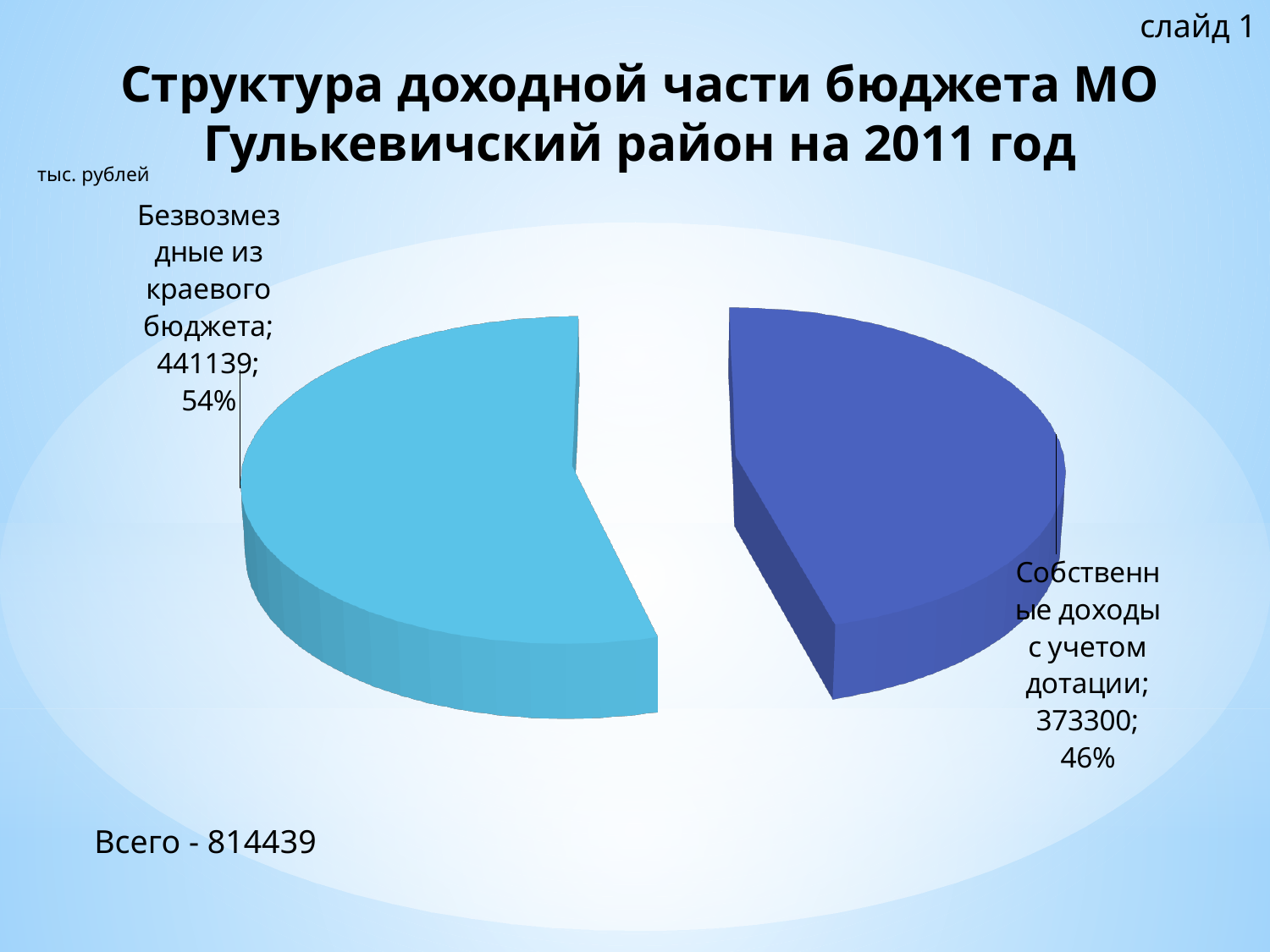
What kind of chart is shown on the slide? Pie chart Which is larger: 'Безвозмездные из краевого бюджета' or 'Собственные доходы с учетом дотации'? Безвозмездные из краевого бюджета Which category has the largest slice of the pie? Безвозмездные из краевого бюджета What is the total of all values shown in the chart? 814439 What is the value for 'Собственные доходы с учетом дотации'? 373300 What share of the pie does 'Собственные доходы с учетом дотации' represent? 46% What share of the pie does 'Безвозмездные из краевого бюджета' represent? 54% What is the value for 'Безвозмездные из краевого бюджета'? 441139 What is the difference between the values for 'Безвозмездные из краевого бюджета' and 'Собственные доходы с учетом дотации'? 67839 How many categories are shown in the pie chart? 2 Which category has the smallest slice of the pie? Собственные доходы с учетом дотации What unit is indicated for the values in the chart? тыс. рублей